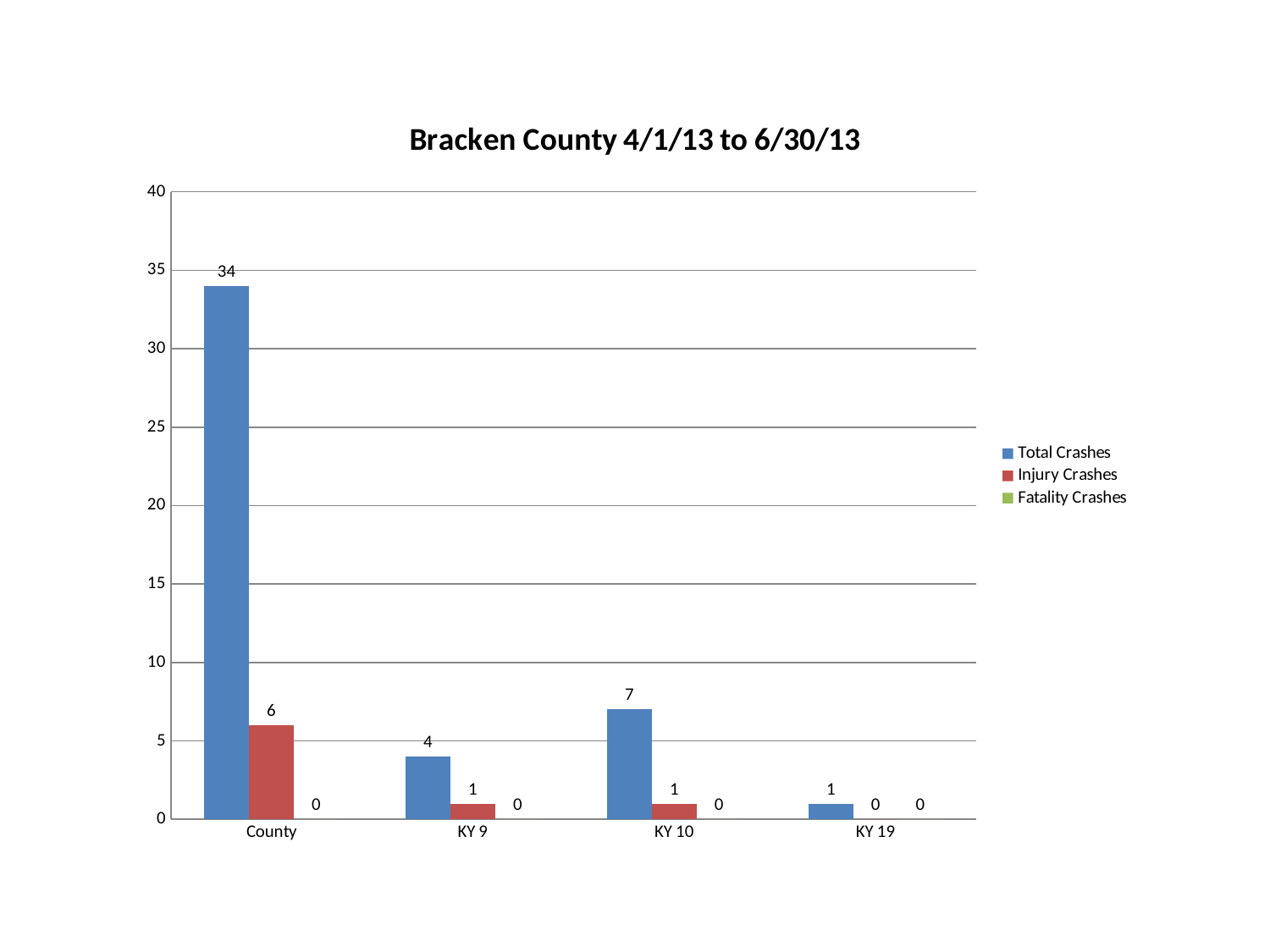
What is the value of Total Crashes for County? 34 What kind of chart is shown on the slide? bar chart What is the difference between Total Crashes for KY 10 and KY 9? 3 How many series does the legend list? 3 Which is larger, Injury Crashes for County or Injury Crashes for KY 9? County Which category has the highest Total Crashes value? County Which category has the lowest Total Crashes value? KY 19 What is the title of the chart? Bracken County 4/1/13 to 6/30/13 How many categories are shown on the x axis? 4 Is the value of Total Crashes for County greater or less than 30? greater What is the value of Injury Crashes for KY 10? 1 What is the value of Fatality Crashes for KY 9? 0